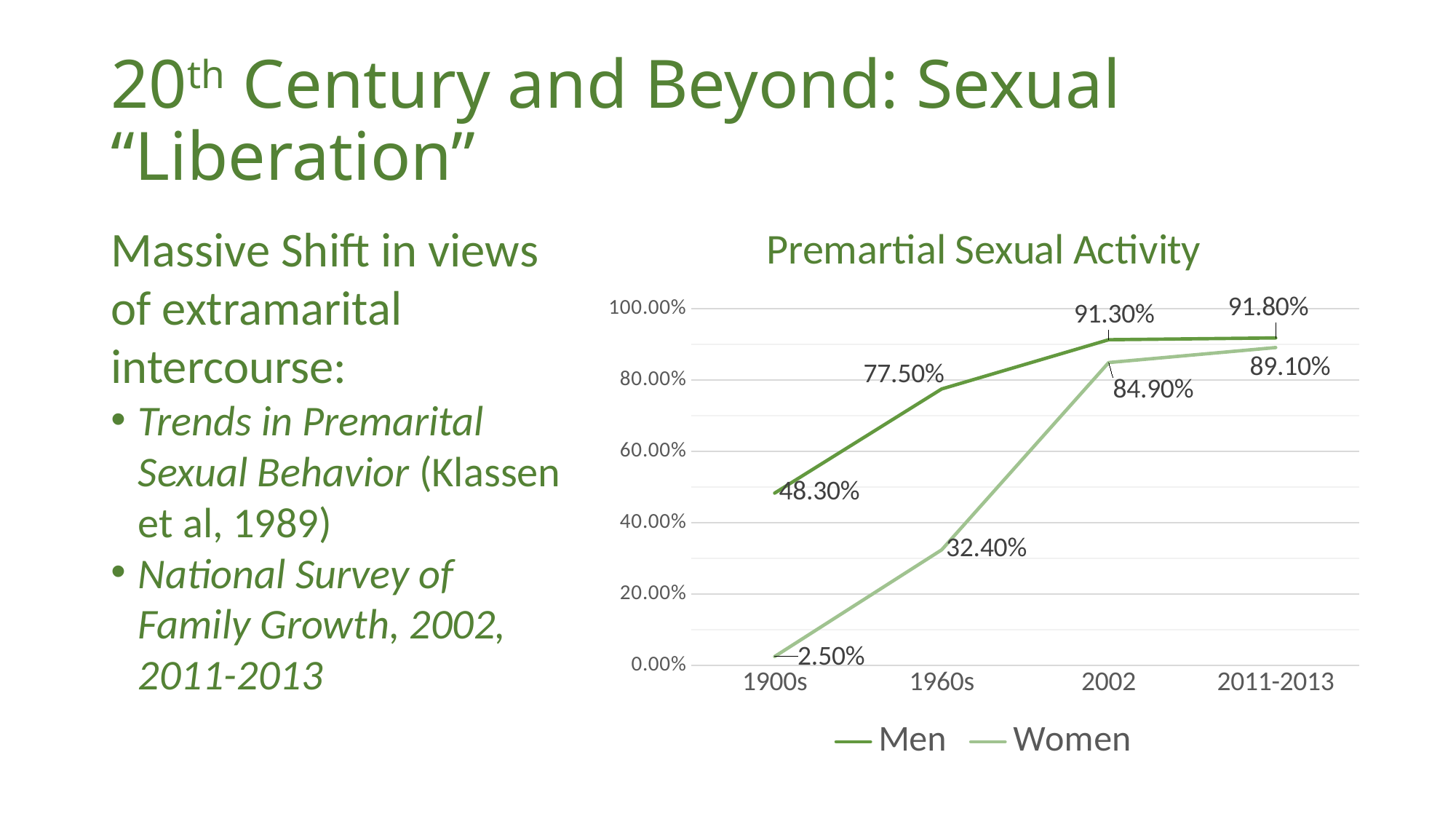
What is the value for Men in 2011-2013? 91.80% How many periods are shown on the x axis? 4 Which is larger in 2002, the value for Men or for Women? Men What is the value for Women in the 1960s? 32.40% In which period is the value for Men highest? 2011-2013 What kind of chart is shown? Line chart In which period is the value for Women lowest? 1900s What is the value for Women in 2002? 84.90% How many series does the legend list? 2 What is the difference between the Men and Women values in the 1960s? 45.10% What is the value for Men in the 1900s? 48.30% Do the values for Women rise or fall from the 1900s to 2011-2013? Rise